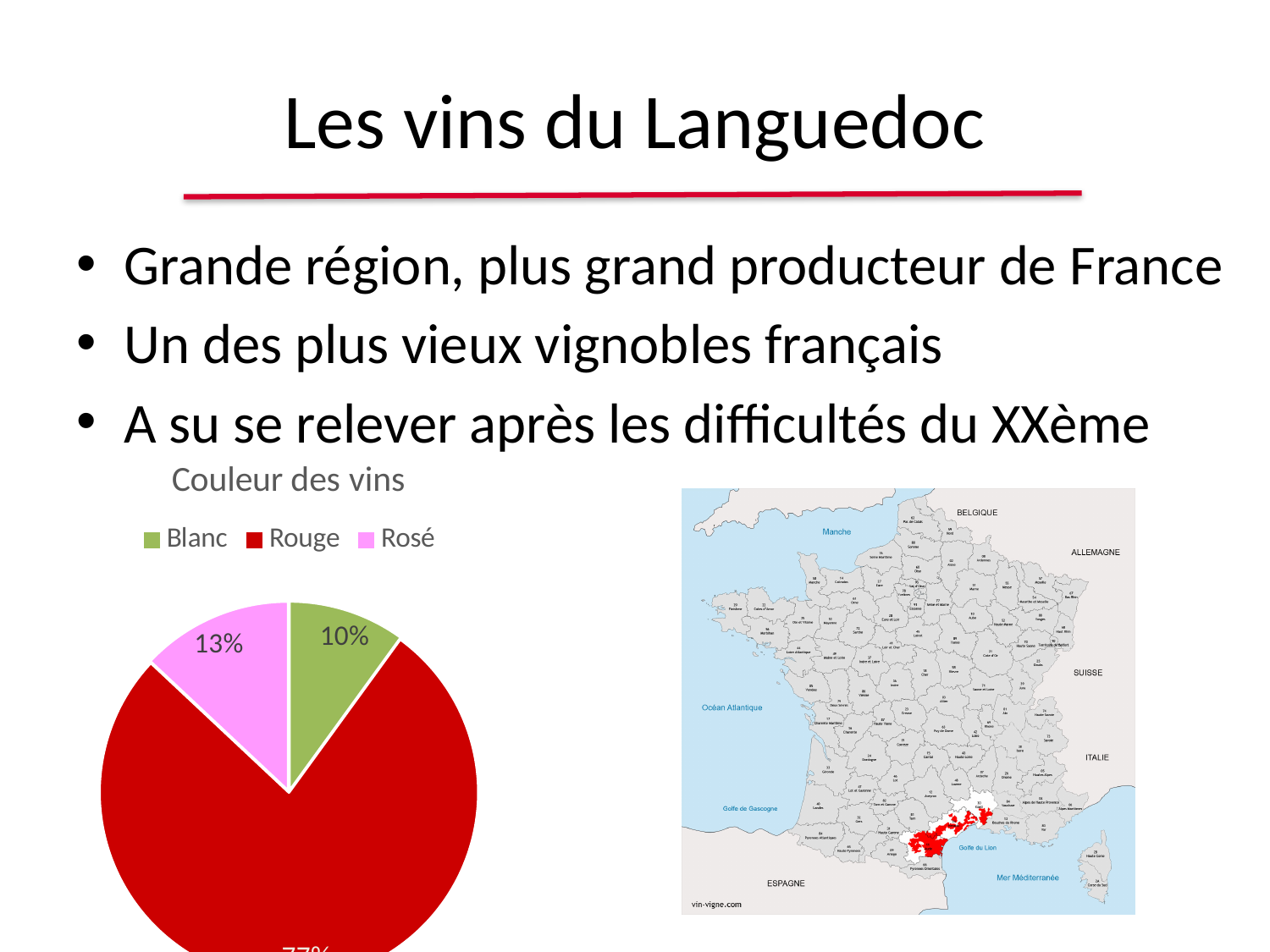
What is the title of the pie chart on the slide? Couleur des vins In the "Couleur des vins" pie chart, which wine colour has the smallest share? Blanc How many entries does the legend of the "Couleur des vins" pie chart list? 3 In the "Couleur des vins" pie chart, which wine colour has the largest share? Rouge What type of chart is shown under the title "Couleur des vins"? pie chart How many slices does the "Couleur des vins" pie chart have? 3 In the "Couleur des vins" pie chart, what is the difference between the Rosé share and the Blanc share? 3% In the "Couleur des vins" pie chart, which is larger: the share for Rosé or the share for Blanc? Rosé In the "Couleur des vins" pie chart, which colour is used for the Rosé slice? pink In the "Couleur des vins" pie chart, what share is labelled for Blanc? 10% In the "Couleur des vins" pie chart, what share is labelled for Rosé? 13%